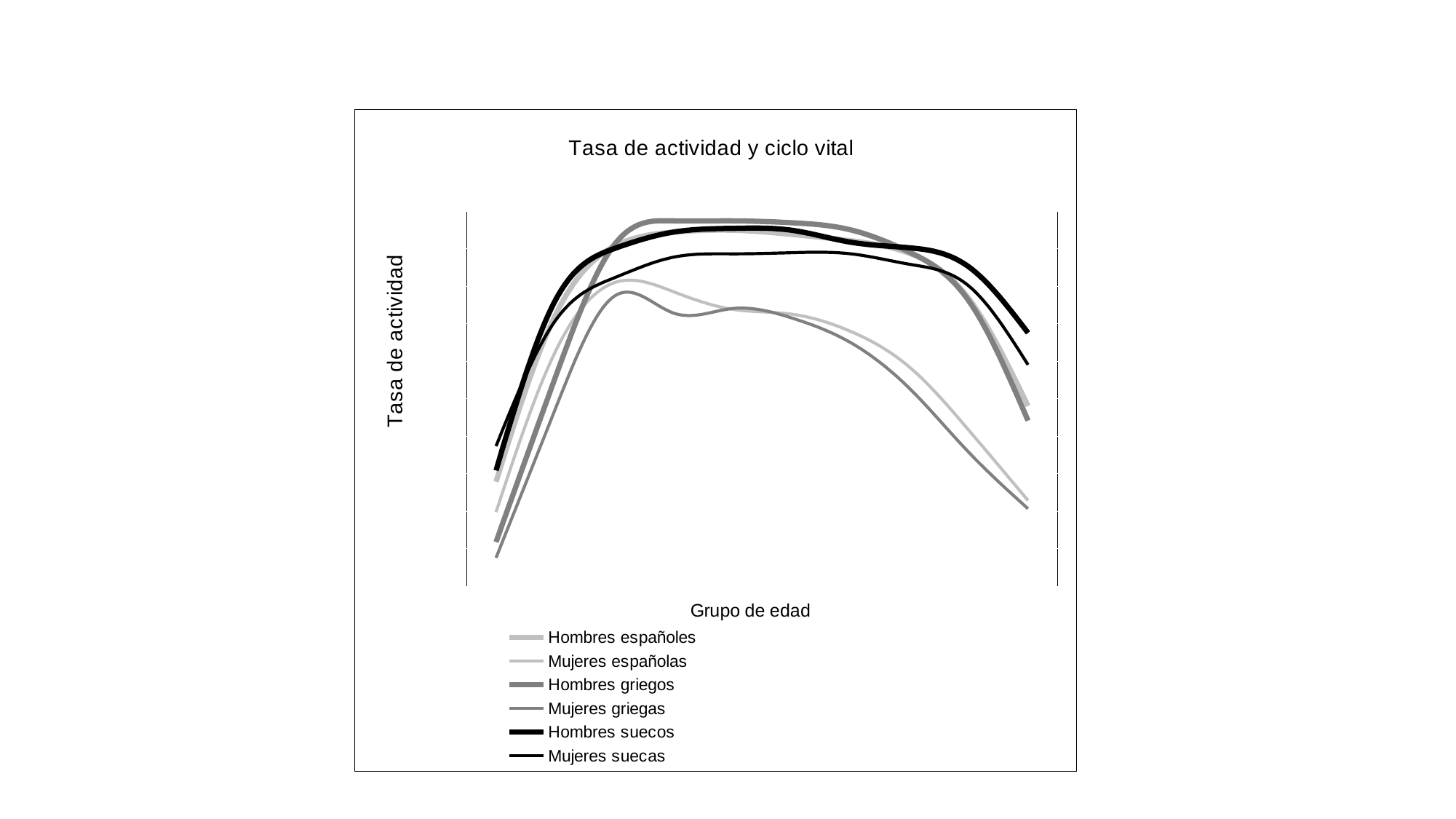
How many series does the legend list? 6 At the rightmost age group, which series has the highest value? Hombres suecos At the rightmost age group, is the value for Hombres suecos or Hombres griegos larger? Hombres suecos Over the first few age groups on the left, does the Hombres suecos series rise or fall? Rise What is the label of the x axis? Grupo de edad At the rightmost age group, is the value for Mujeres suecas or Mujeres griegas larger? Mujeres suecas What is the title of the chart? Tasa de actividad y ciclo vital Over the right half of the x axis, does the Mujeres griegas series rise or fall? Fall What kind of chart is shown on the slide? Line chart In the middle age groups, is the value for Hombres griegos or Mujeres griegas larger? Hombres griegos